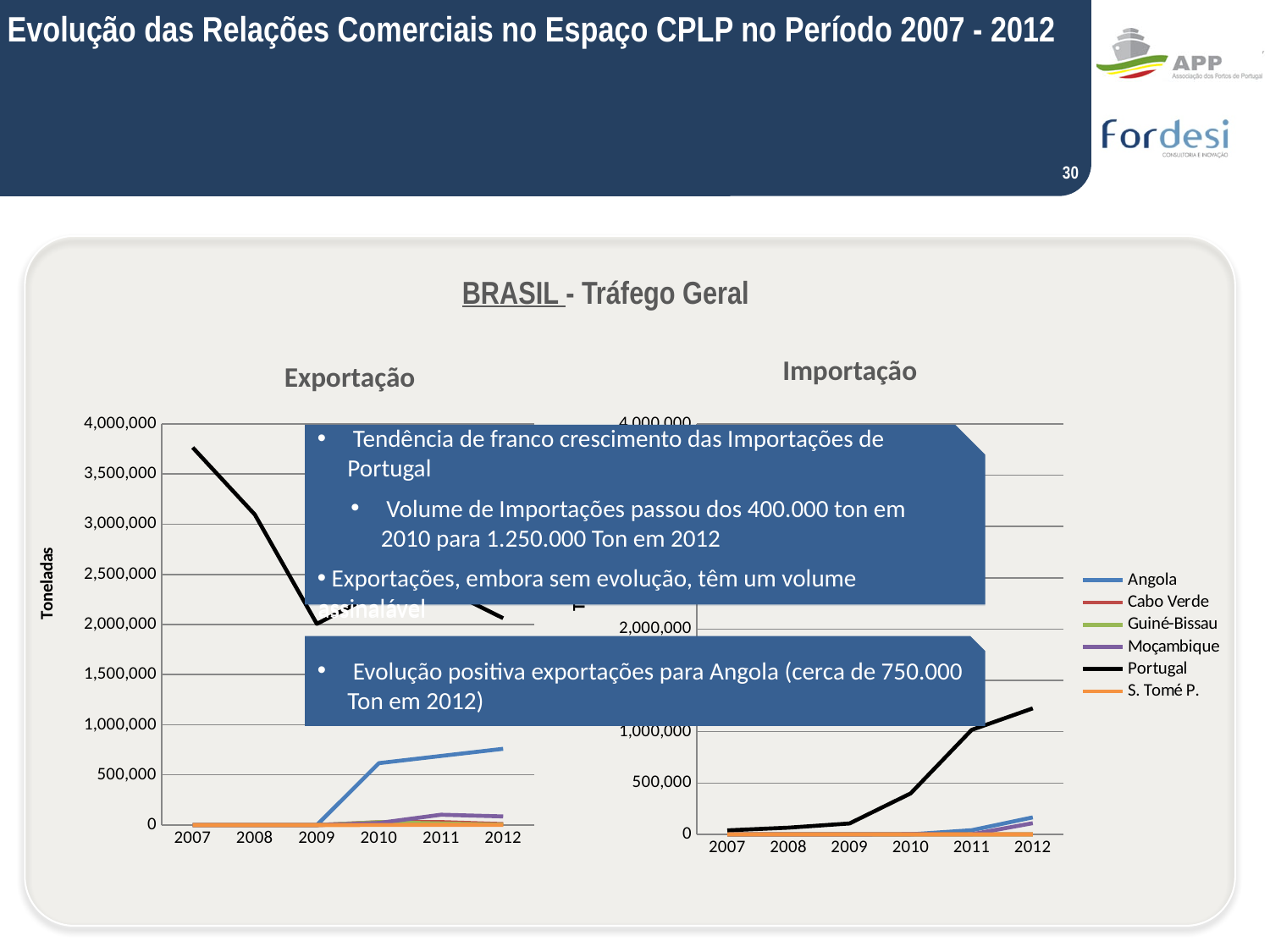
In the Importação chart, do the values for Portugal rise or fall from 2007 to 2012? rise In the Exportação chart, is the value for Portugal in 2007 greater or less than 3,500,000? greater In the Exportação chart, do the values for Portugal rise or fall from 2007 to 2009? fall How many years are plotted on the x axis of the Importação chart? 6 In the Exportação chart, is the value for Angola in 2012 greater or less than 500,000? greater How many series does the legend list? 6 In the Exportação chart, which series has the highest value in 2007? Portugal What is the label on the y axis of the Exportação chart? Toneladas In the Importação chart, is the value for Portugal in 2012 greater or less than 1,000,000? greater What kind of chart is the Exportação chart? line chart In the Exportação chart, is the value for Portugal larger in 2007 or in 2012? 2007